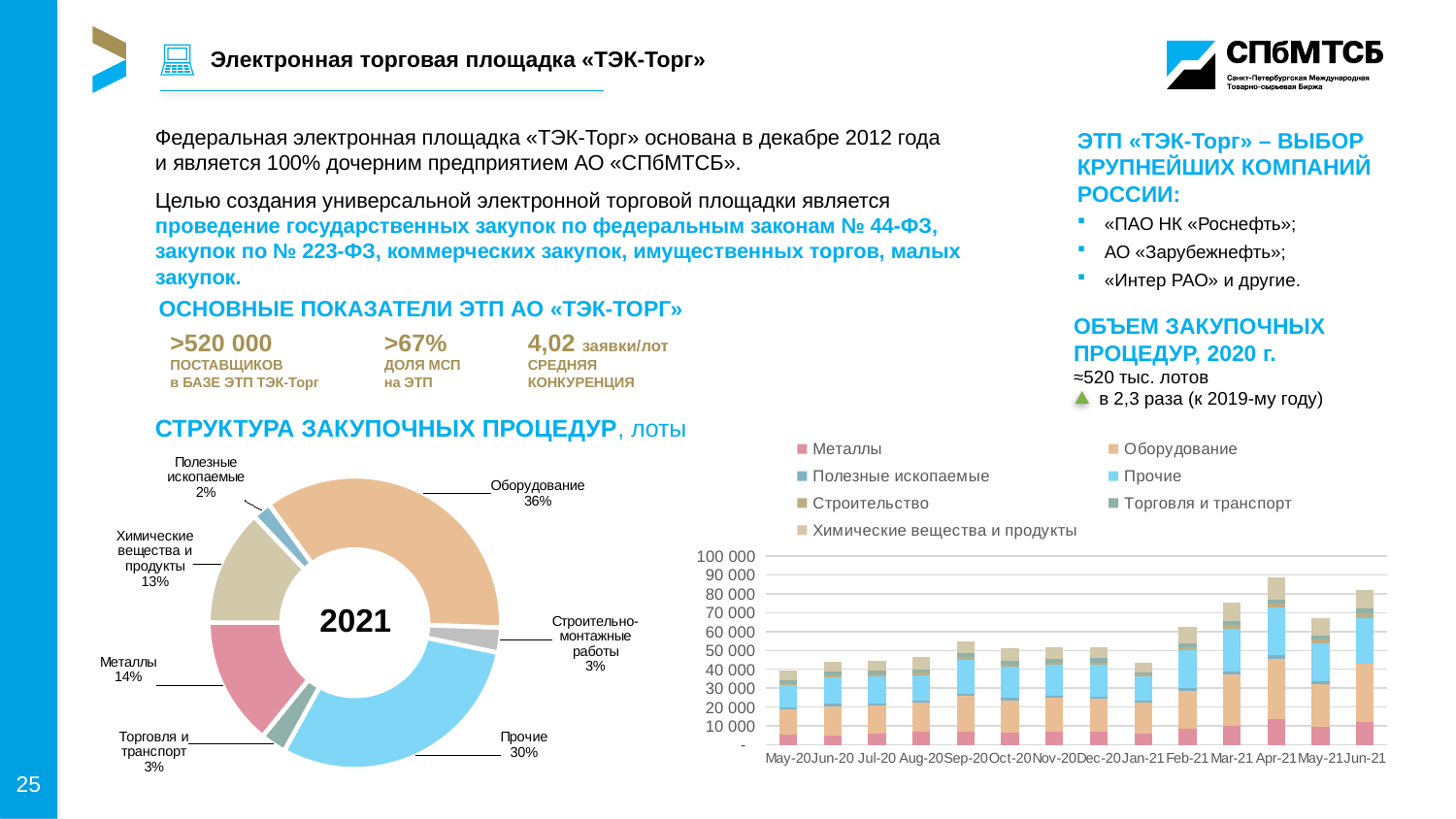
In the donut chart 'СТРУКТУРА ЗАКУПОЧНЫХ ПРОЦЕДУР, лоты', what share does Прочие have? 30% In the donut chart 'СТРУКТУРА ЗАКУПОЧНЫХ ПРОЦЕДУР, лоты', what is the difference in percentage points between Металлы and Химические вещества и продукты? 1 percentage point In the donut chart 'СТРУКТУРА ЗАКУПОЧНЫХ ПРОЦЕДУР, лоты', which is larger: Металлы or Химические вещества и продукты? Металлы How many series does the legend of the monthly stacked bar chart on the right list? 7 In the donut chart 'СТРУКТУРА ЗАКУПОЧНЫХ ПРОЦЕДУР, лоты', which category has the smallest share? Полезные ископаемые How many categories are shown in the donut chart 'СТРУКТУРА ЗАКУПОЧНЫХ ПРОЦЕДУР, лоты'? 7 In the monthly stacked bar chart on the right, is the total for Apr-21 greater or less than 80 000? greater In the donut chart 'СТРУКТУРА ЗАКУПОЧНЫХ ПРОЦЕДУР, лоты', what share does Оборудование have? 36% What kind of chart is the monthly chart on the right side of the slide (May-20 to Jun-21)? Stacked bar chart In the donut chart 'СТРУКТУРА ЗАКУПОЧНЫХ ПРОЦЕДУР, лоты', which category has the largest share? Оборудование In the monthly stacked bar chart on the right, which month has the tallest bar? Apr-21 What year is shown in the centre of the donut chart 'СТРУКТУРА ЗАКУПОЧНЫХ ПРОЦЕДУР, лоты'? 2021